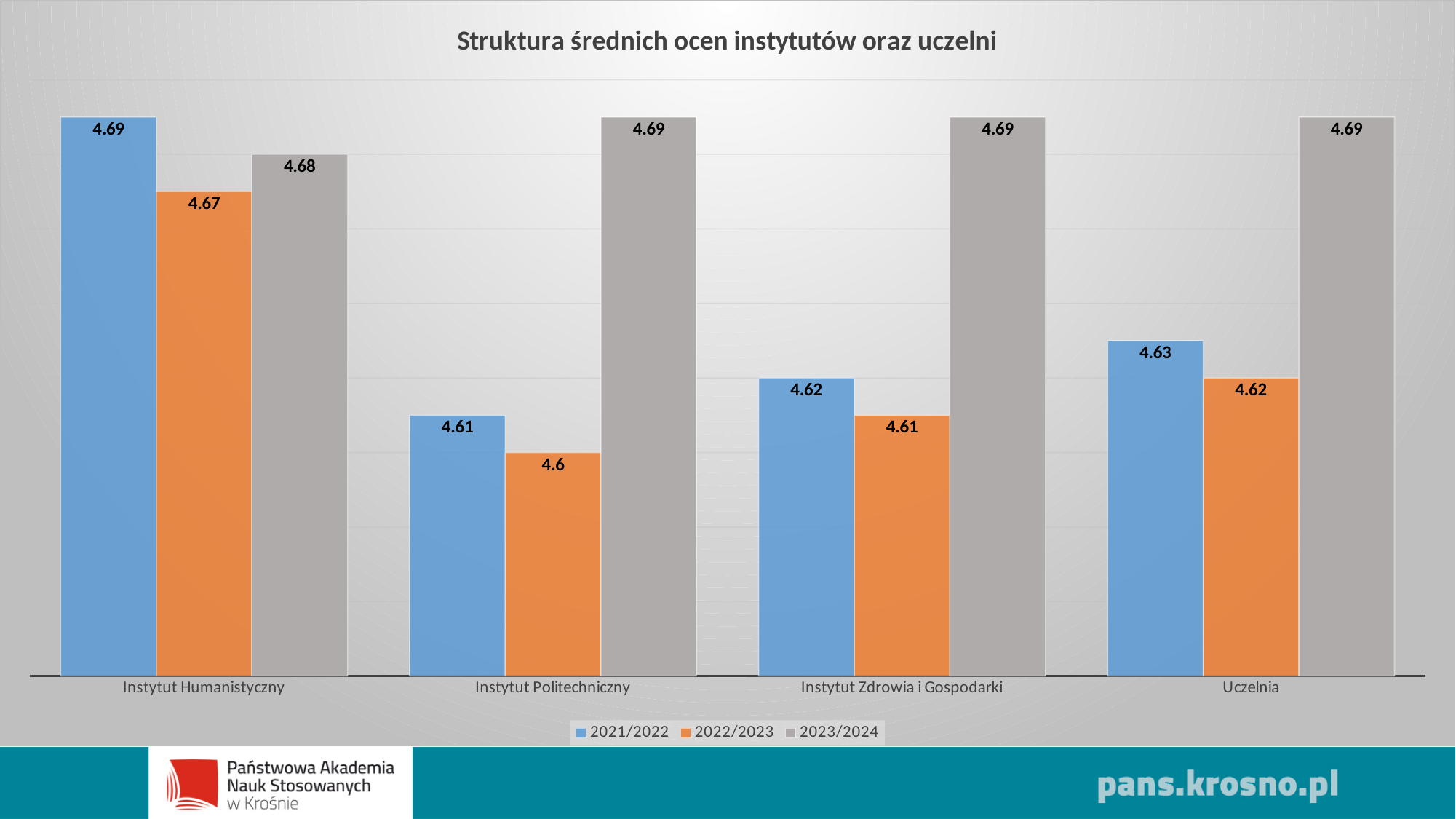
What is the title of the chart? Struktura średnich ocen instytutów oraz uczelni What is the value for Instytut Zdrowia i Gospodarki in the 2021/2022 series? 4.62 What is the value for Instytut Humanistyczny in the 2021/2022 series? 4.69 Which category has the lowest value in the 2022/2023 series? Instytut Politechniczny Which category has the highest value in the 2021/2022 series? Instytut Humanistyczny What kind of chart is shown on the slide? Bar chart How many series does the legend list? 3 How many categories are shown on the x axis? 4 What is the difference between the 2023/2024 and 2022/2023 values for Instytut Politechniczny? 0.09 What is the value for Uczelnia in the 2023/2024 series? 4.69 Which is larger for Instytut Humanistyczny: the 2021/2022 value or the 2022/2023 value? 2021/2022 What is the value for Instytut Politechniczny in the 2022/2023 series? 4.6